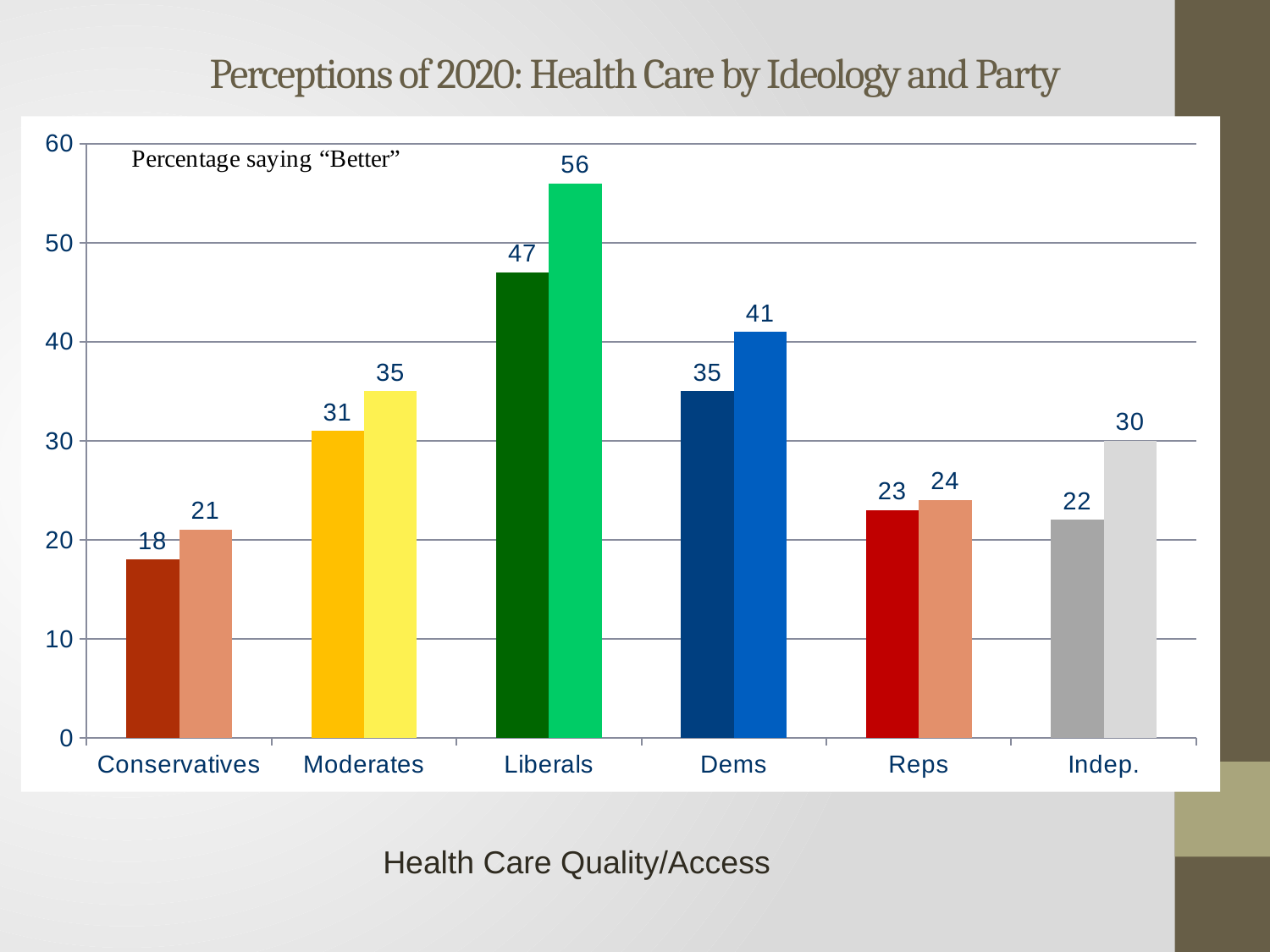
What kind of chart is shown on the slide? bar chart Which category has the highest bar on the chart? Liberals What is the title of the slide? Perceptions of 2020: Health Care by Ideology and Party Which is larger, the left bar for Moderates or the left bar for Dems? Dems What is the difference between the two bars for Liberals? 9 What is the difference between the right bar for Dems and the right bar for Reps? 17 Is the right bar for Indep. greater or less than 20? greater What is the value of the left bar for Conservatives? 18 How many categories are shown on the x axis? 6 Which category has the lowest bar on the chart? Conservatives What is the value of the right (lighter) bar for Indep.? 30 What is the value of the left (darker) bar for Liberals? 47